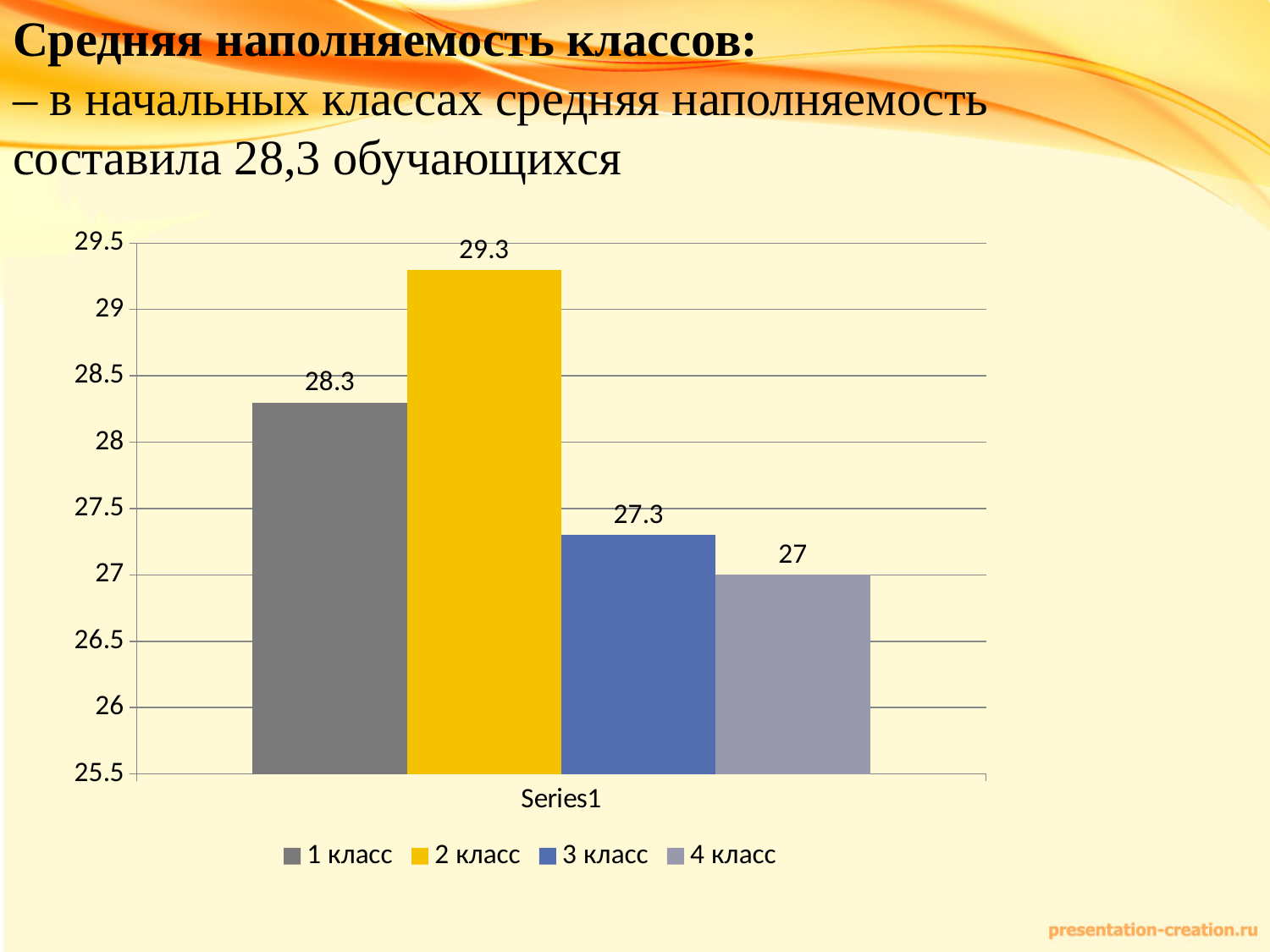
What is the difference between the values for 2 класс and 1 класс? 1 What is the value for 2 класс? 29.3 What is the value for 4 класс? 27 What is the value for 1 класс? 28.3 What kind of chart is shown on the slide? bar chart What colour is the bar for 2 класс? yellow Which class has the highest value? 2 класс Which class has the lowest value? 4 класс What is the value for 3 класс? 27.3 What is the difference between the values for 3 класс and 4 класс? 0.3 Which is larger, the value for 1 класс or the value for 3 класс? 1 класс How many series does the legend list? 4